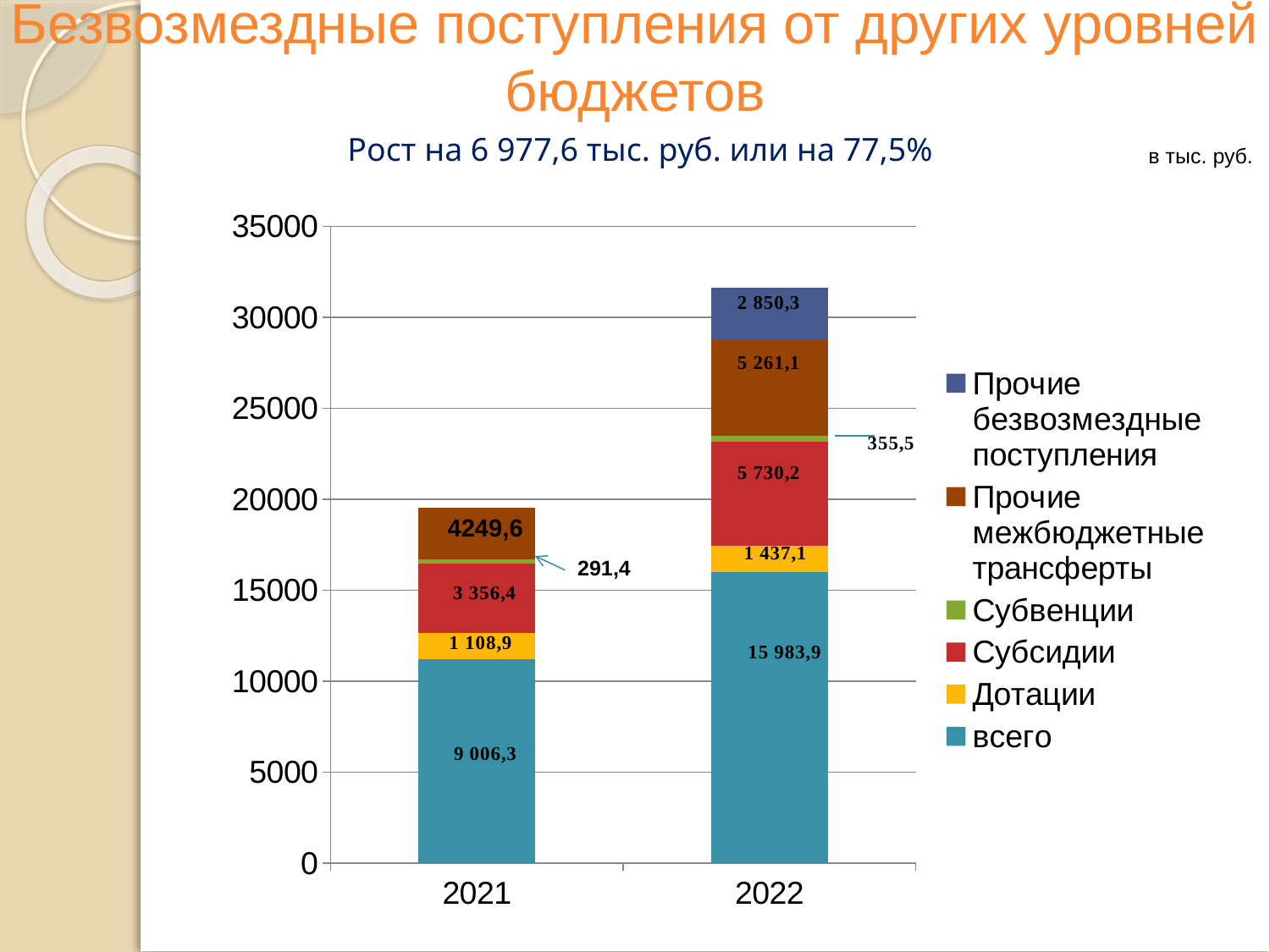
What is the value of the "Субсидии" segment for 2021? 3 356,4 What is the value of the "Субвенции" segment for 2022? 355,5 By how much did the "Дотации" value change from 2021 to 2022? 328,2 What is the value of the "Прочие безвозмездные поступления" segment for 2022? 2 850,3 What is the value of the "Прочие межбюджетные трансферты" segment for 2021? 4249,6 How many categories (years) are shown on the x axis? 2 How many series does the legend list? 6 Which year has the larger "Субсидии" value, 2021 or 2022? 2022 What is the difference between the "всего" values for 2022 and 2021? 6 977,6 What is the title of the chart on the slide? Безвозмездные поступления от других уровней бюджетов What kind of chart is shown on the slide? Stacked bar chart What is the value of the "всего" segment for 2022? 15 983,9